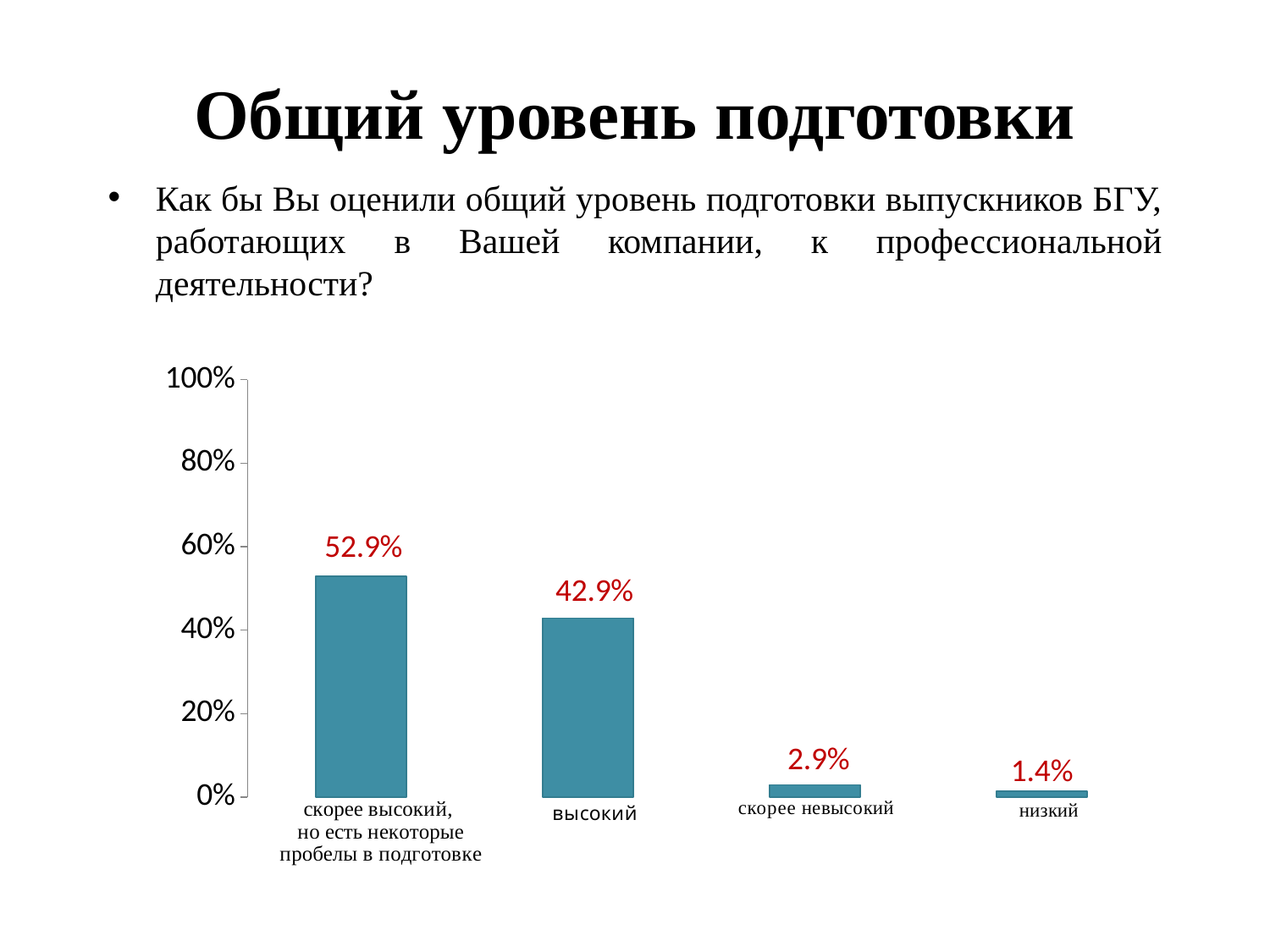
How many categories are shown in the chart? 4 What is the value for the category "скорее невысокий"? 2.9% What is the title of the slide containing the chart? Общий уровень подготовки Which category has the highest value? скорее высокий, но есть некоторые пробелы в подготовке Do the values rise or fall from left to right along the x axis? fall What is the value for the category "высокий"? 42.9% Which category has the lowest value? низкий What is the difference between the values for "скорее высокий, но есть некоторые пробелы в подготовке" and "высокий"? 10% What is the value for the category "низкий"? 1.4% Which is larger: the value for "скорее невысокий" or the value for "низкий"? скорее невысокий Is the value for "высокий" greater or less than 40%? greater What kind of chart is shown on the slide? bar chart